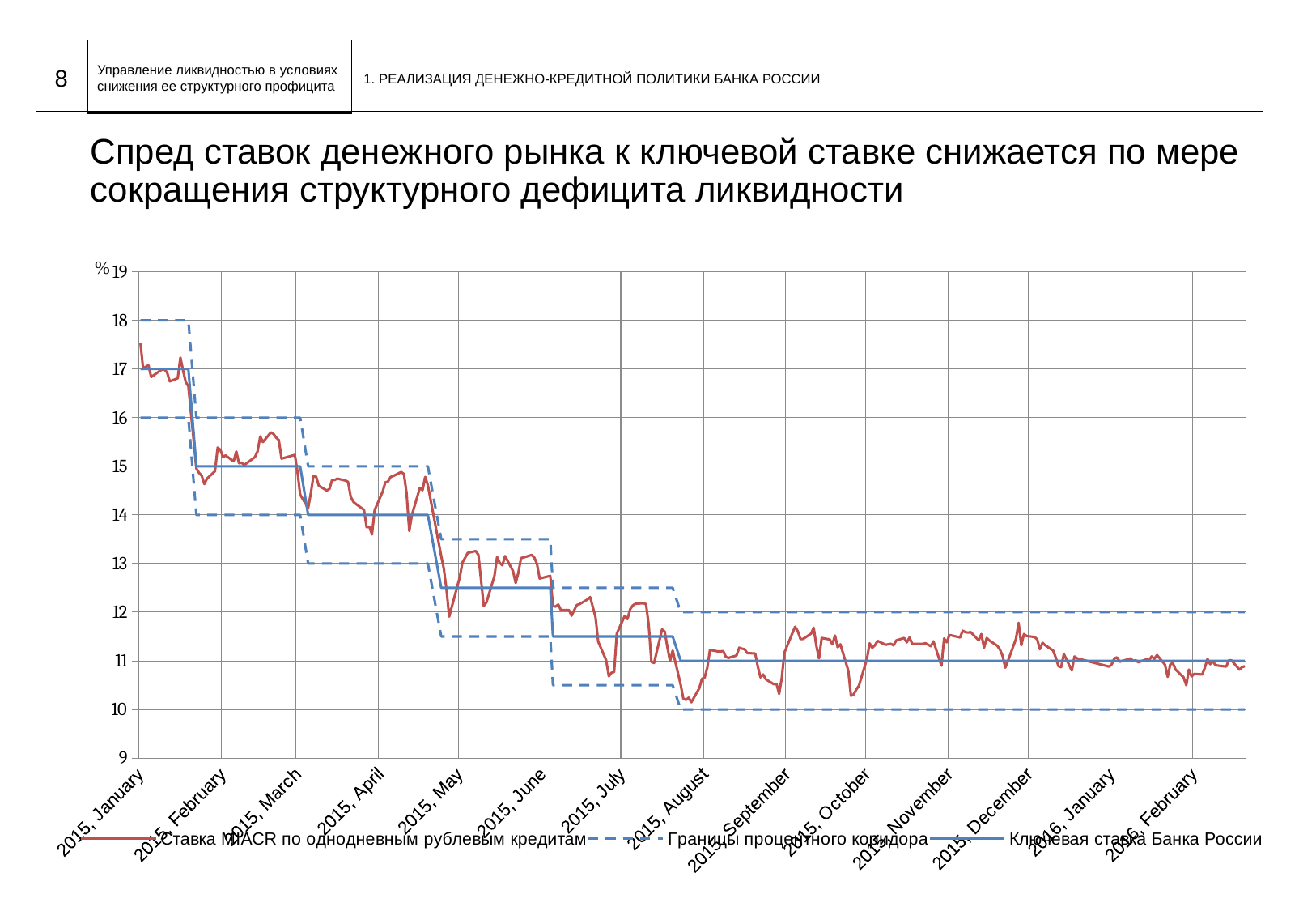
Does the key rate of the Bank of Russia (Ключевая ставка Банка России) rise or fall over the period shown? fall Which series is drawn as a red line according to the legend? Ставка MIACR по однодневным рублевым кредитам What is the key rate of the Bank of Russia from August 2015 to February 2016? 11 What is the upper bound of the interest rate corridor in January 2015? 18 What is the key rate of the Bank of Russia at the start of January 2015? 17 What is the key rate of the Bank of Russia in April 2015? 14 How many month labels are shown on the x axis? 14 How many series does the legend list? 3 Is the MIACR rate in October 2015 greater or less than 12? less Is the MIACR rate at the start of January 2015 greater or less than 16? greater What is the lower bound of the interest rate corridor from August 2015 onward? 10 What kind of chart is shown on the slide? line chart